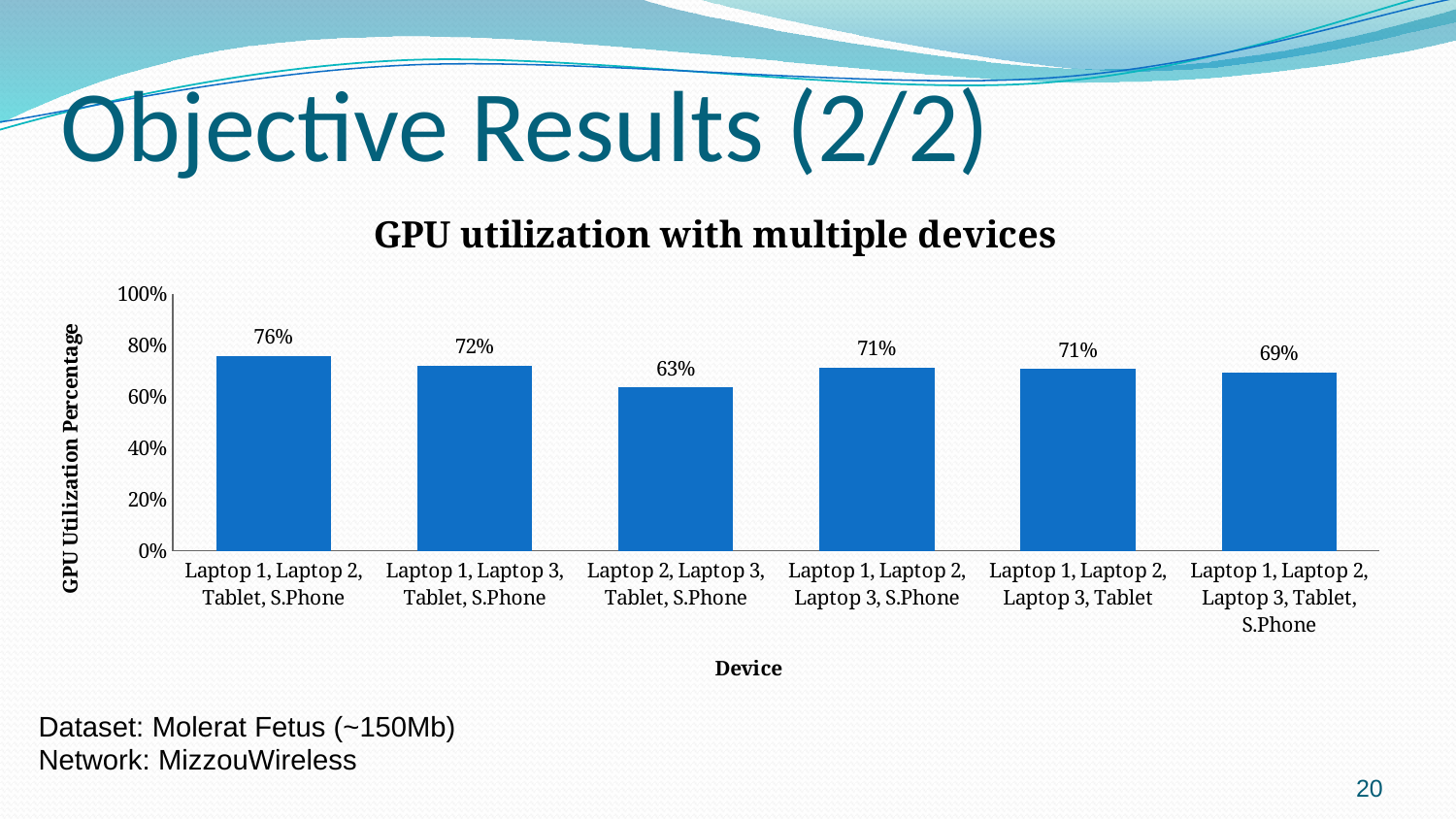
What is the difference in GPU utilization between 'Laptop 1, Laptop 2, Tablet, S.Phone' and 'Laptop 2, Laptop 3, Tablet, S.Phone'? 13% What is the label of the vertical axis? GPU Utilization Percentage Which device combination has the lowest GPU utilization percentage? Laptop 2, Laptop 3, Tablet, S.Phone What is the GPU utilization percentage for 'Laptop 1, Laptop 2, Laptop 3, Tablet, S.Phone'? 69% What type of chart is used to show GPU utilization with multiple devices? Bar chart What is the title of the chart? GPU utilization with multiple devices What is the GPU utilization percentage for the device combination 'Laptop 1, Laptop 2, Tablet, S.Phone'? 76% How many device combinations are shown in the chart? 6 Is the GPU utilization for 'Laptop 2, Laptop 3, Tablet, S.Phone' greater or less than 80%? less What is the GPU utilization percentage for 'Laptop 2, Laptop 3, Tablet, S.Phone'? 63% Which device combination has the highest GPU utilization percentage? Laptop 1, Laptop 2, Tablet, S.Phone Which has a higher GPU utilization: 'Laptop 1, Laptop 3, Tablet, S.Phone' or 'Laptop 1, Laptop 2, Laptop 3, Tablet, S.Phone'? Laptop 1, Laptop 3, Tablet, S.Phone